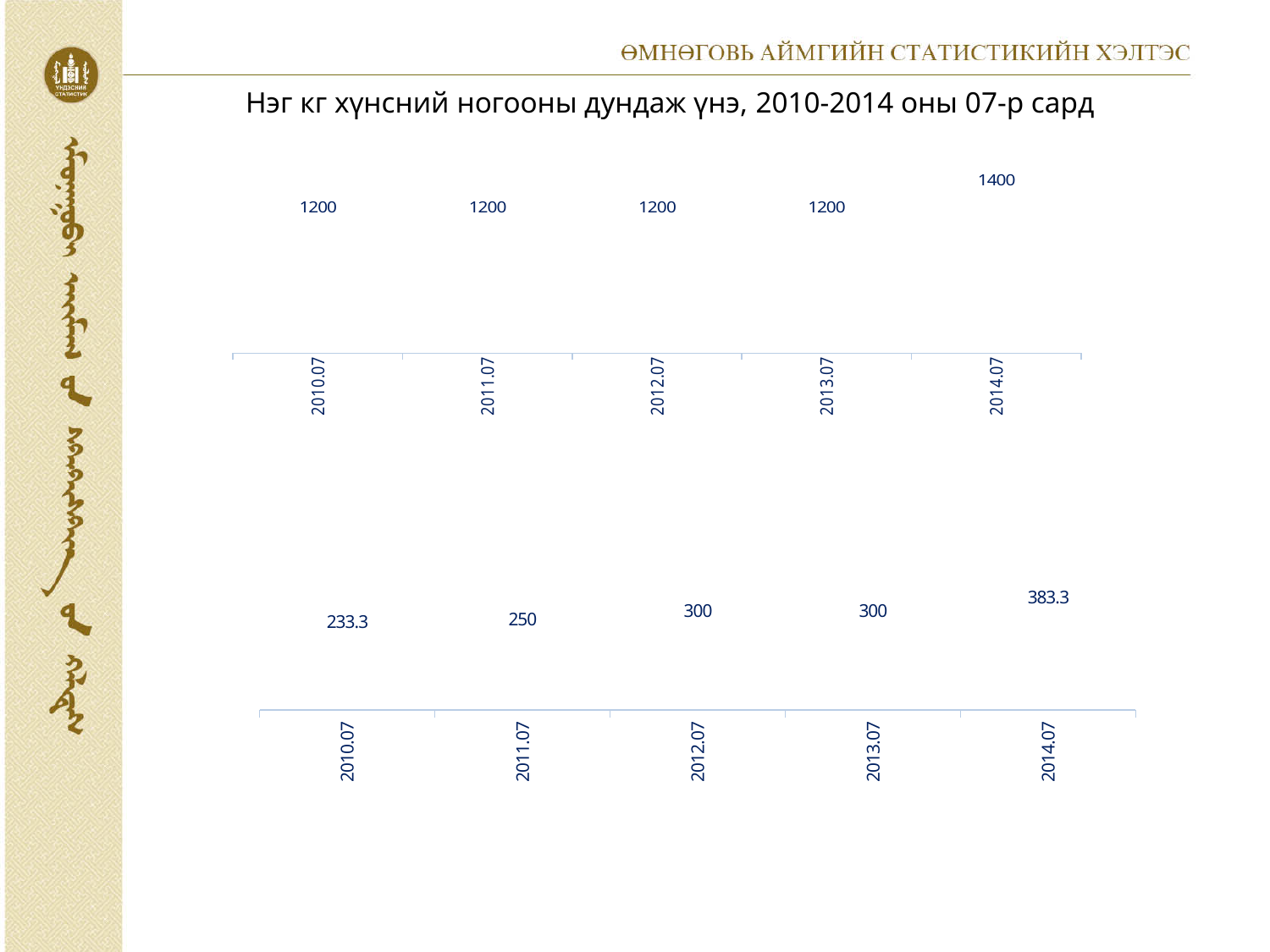
In the top chart, what is the value for 2014.07? 1400 In the bottom chart, which period has the highest value? 2014.07 In the bottom chart, which period has the lowest value? 2010.07 In the bottom chart, what is the value for 2010.07? 233.3 How many periods are shown on the x axis of the bottom chart? 5 In the top chart, what is the difference between the values for 2014.07 and 2013.07? 200 In the bottom chart, what is the value for 2011.07? 250 In the bottom chart, which is larger, the value for 2011.07 or the value for 2012.07? 2012.07 In the top chart, what is the value for 2011.07? 1200 In the top chart, which period has the highest value? 2014.07 In the bottom chart, what is the difference between the values for 2014.07 and 2012.07? 83.3 In the bottom chart, what is the value for 2014.07? 383.3